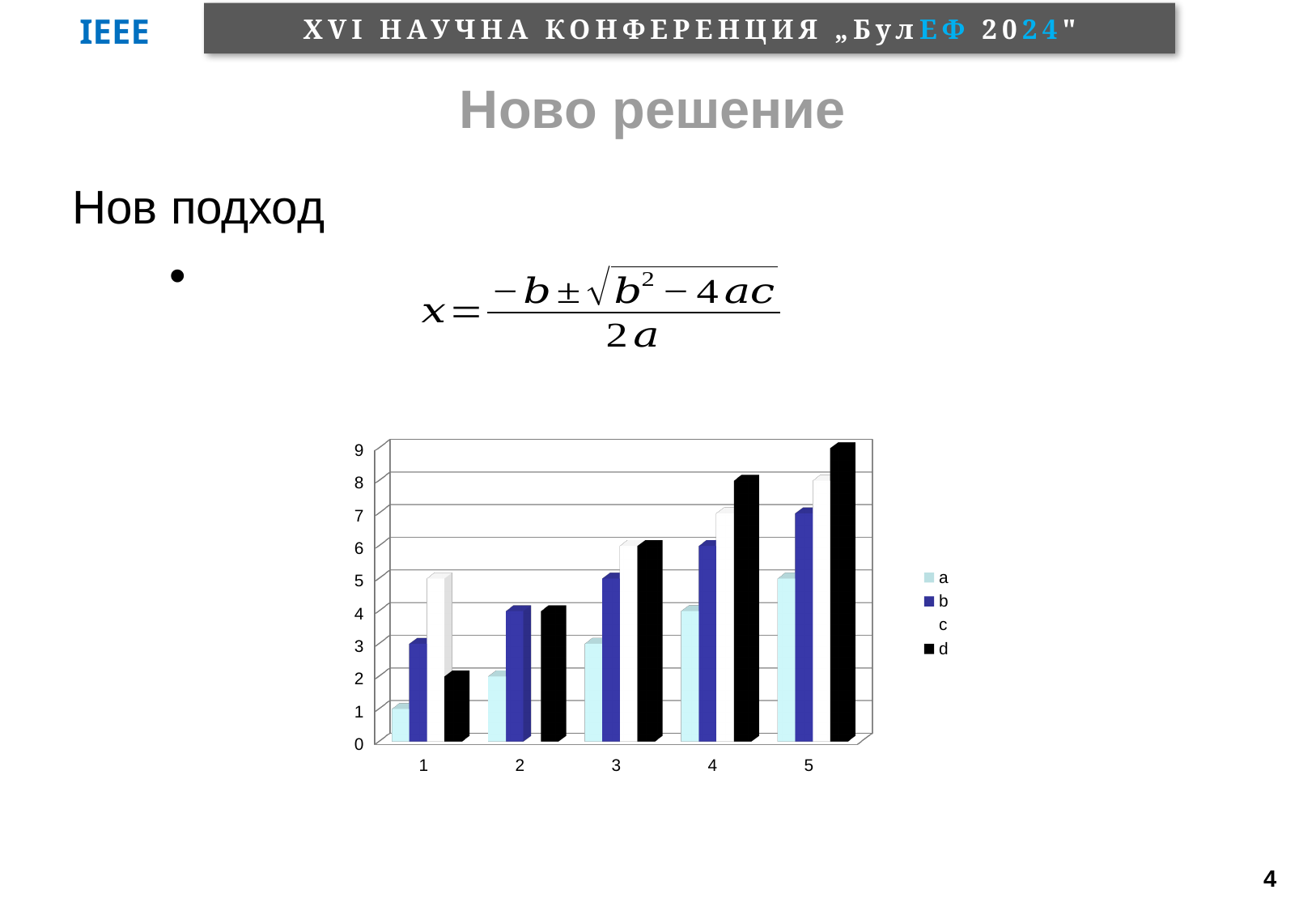
What are the series names listed in the legend? a, b, c, d Is the value of series a at category 1 greater or less than 2? less Is the value of series d at category 5 greater or less than 8? greater How many categories are shown on the x axis? 5 Do the values of series a rise or fall from category 1 to category 5? rise Do the values of series d rise or fall from category 1 to category 5? rise Which series is drawn in black? d For series a, which category has the lowest value? 1 Is the value of series b at category 4 greater or less than 5? greater How many series does the legend list? 4 At category 1, which is larger: the value of series c or the value of series d? c What kind of chart is shown on the slide? bar chart